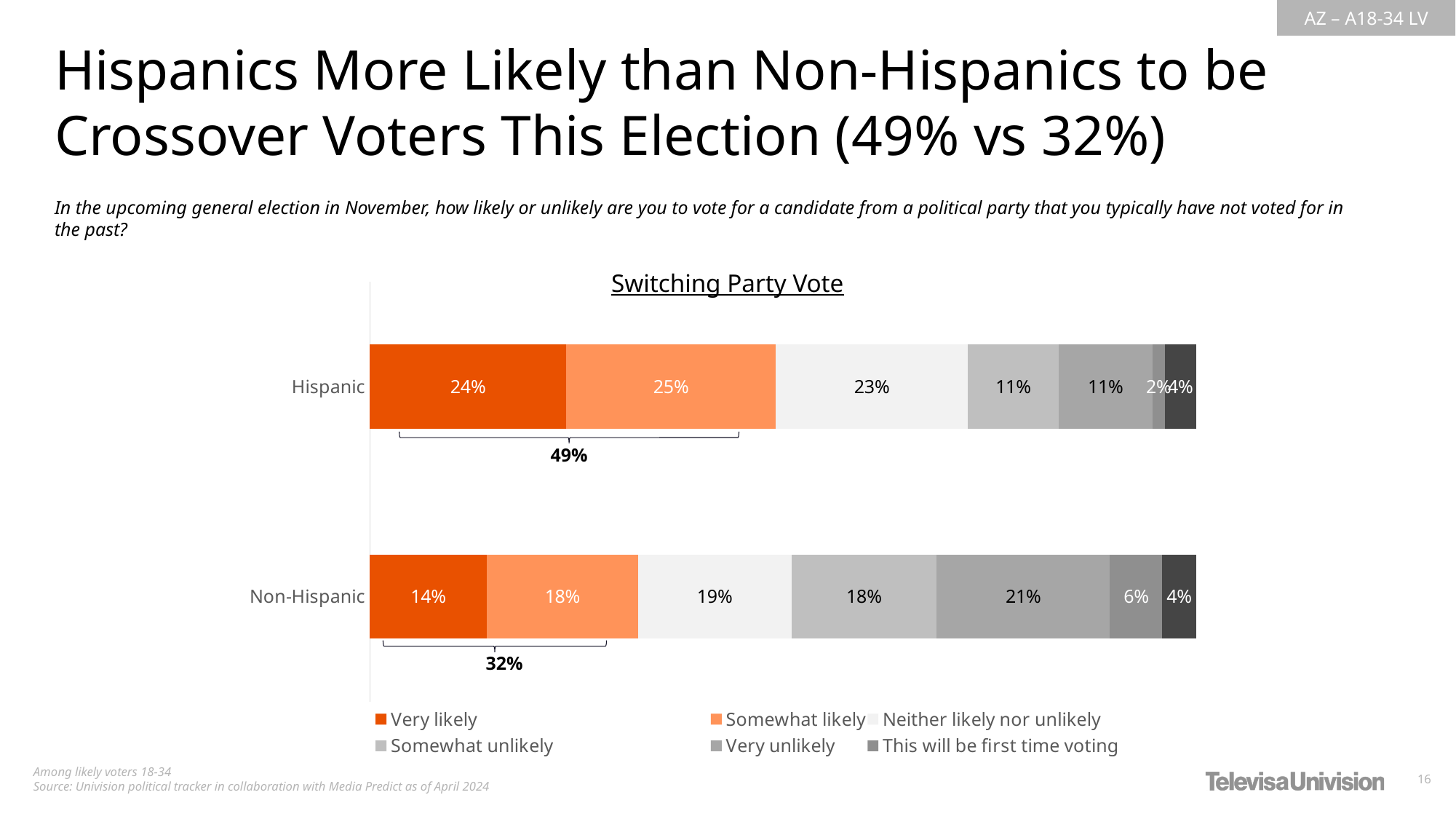
What is the "Neither likely nor unlikely" value for Hispanic respondents? 23% What percentage of Non-Hispanic respondents are "Somewhat likely" to switch their party vote? 18% What is the "Very unlikely" value for Non-Hispanic respondents? 21% How many percentage points higher is the "Very unlikely" share for Non-Hispanic respondents than for Hispanic respondents? 10 percentage points How many series does the chart legend list? 6 What combined "Very likely" plus "Somewhat likely" share is shown by the bracket under the Hispanic bar? 49% What is the title of the chart? Switching Party Vote What is the difference between the bracketed combined likely shares for Hispanic (49%) and Non-Hispanic (32%) respondents? 17 percentage points Which group has the larger "Very likely" share, Hispanic or Non-Hispanic? Hispanic How many groups (categories) are plotted in the chart? 2 What percentage of Hispanic respondents are "Very likely" to switch their party vote? 24% What kind of chart is shown under the title "Switching Party Vote"? Stacked bar chart